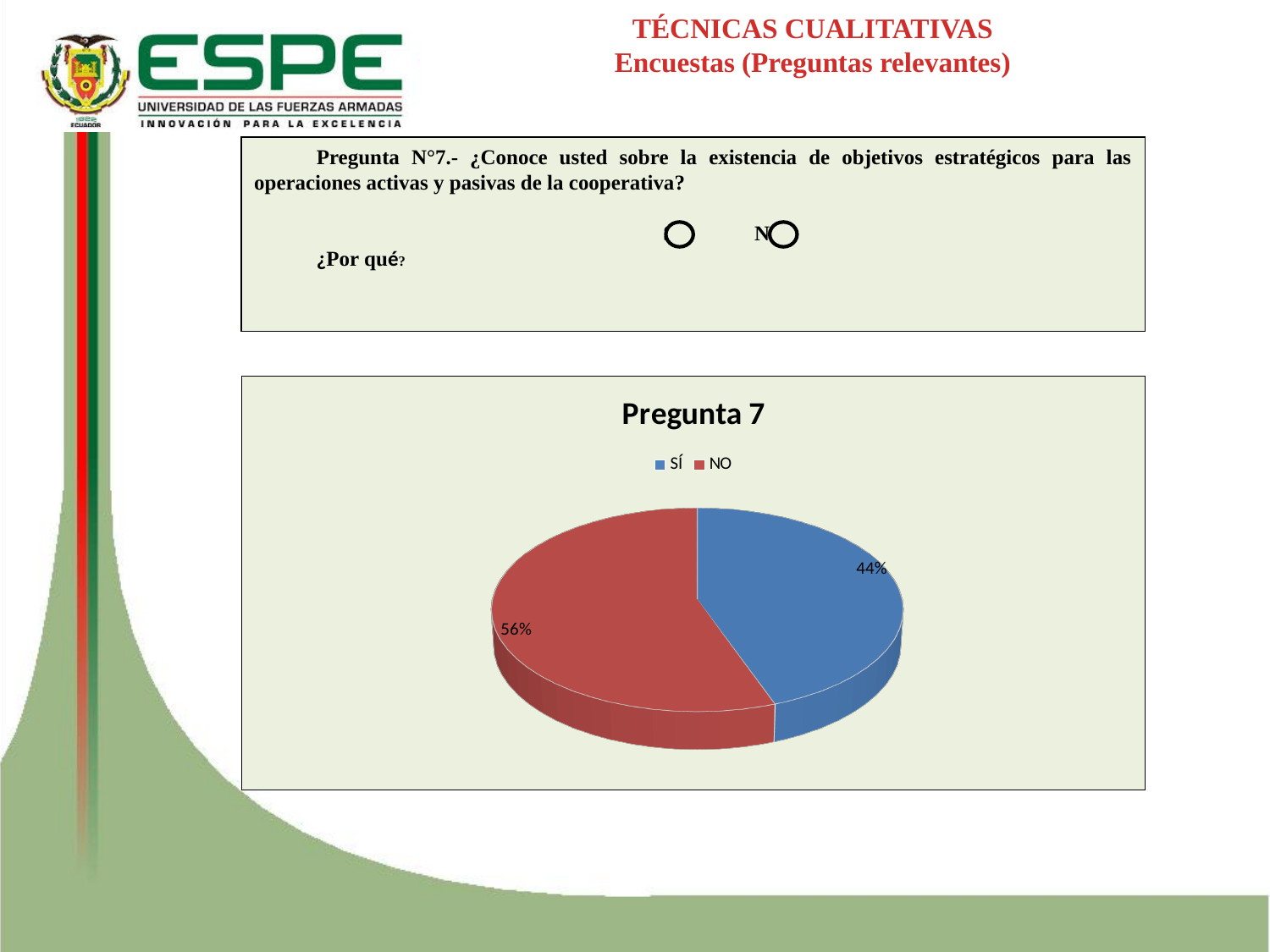
Which category has the smallest share of the pie chart? SÍ What is the title of the chart? Pregunta 7 Is the share for SÍ greater or less than 50%? less What is the difference in percentage points between the NO and SÍ slices? 12 What colour is the NO slice in the pie chart? Red How many slices does the pie chart have? 2 What percentage of the pie chart corresponds to NO? 56% What percentage of the pie chart corresponds to SÍ? 44% Which slice is larger, SÍ or NO? NO What type of chart is shown on the slide? Pie chart Which category has the largest share of the pie chart? NO How many entries does the chart legend list? 2